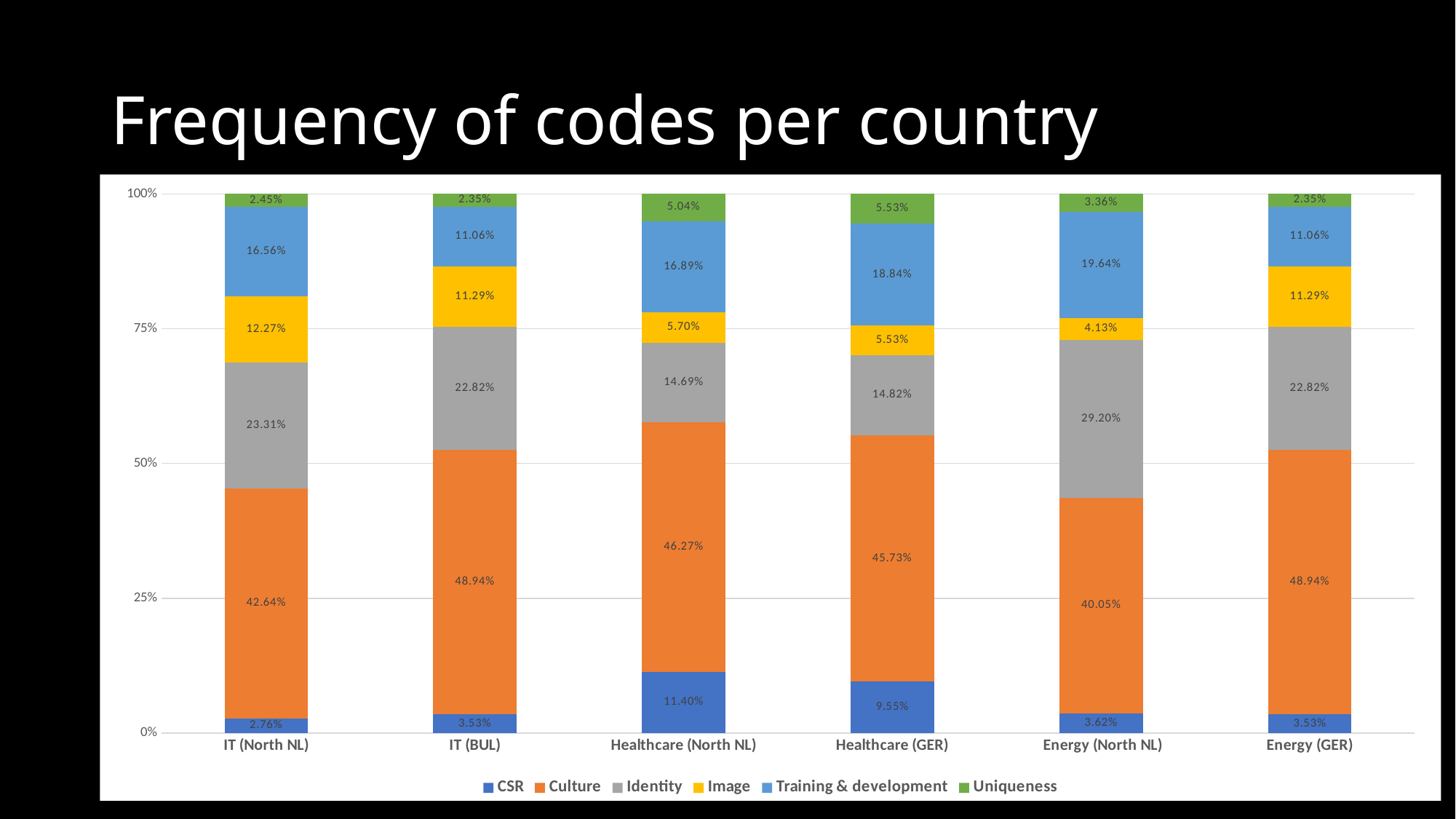
What is the CSR value for Healthcare (North NL)? 11.40% What kind of chart is shown on the slide? Stacked bar chart What is the title of the slide? Frequency of codes per country How many categories are shown on the x axis? 6 Which has a larger Uniqueness value, Healthcare (GER) or Healthcare (North NL)? Healthcare (GER) Which category has the lowest Image value? Energy (North NL) Which category has the highest Identity value? Energy (North NL) Which category has the highest CSR value? Healthcare (North NL) What is the Culture value for IT (BUL)? 48.94% What is the Training & development value for Energy (North NL)? 19.64% How much larger is the Culture value for IT (BUL) than for IT (North NL)? 6.30 percentage points How many series does the legend list? 6